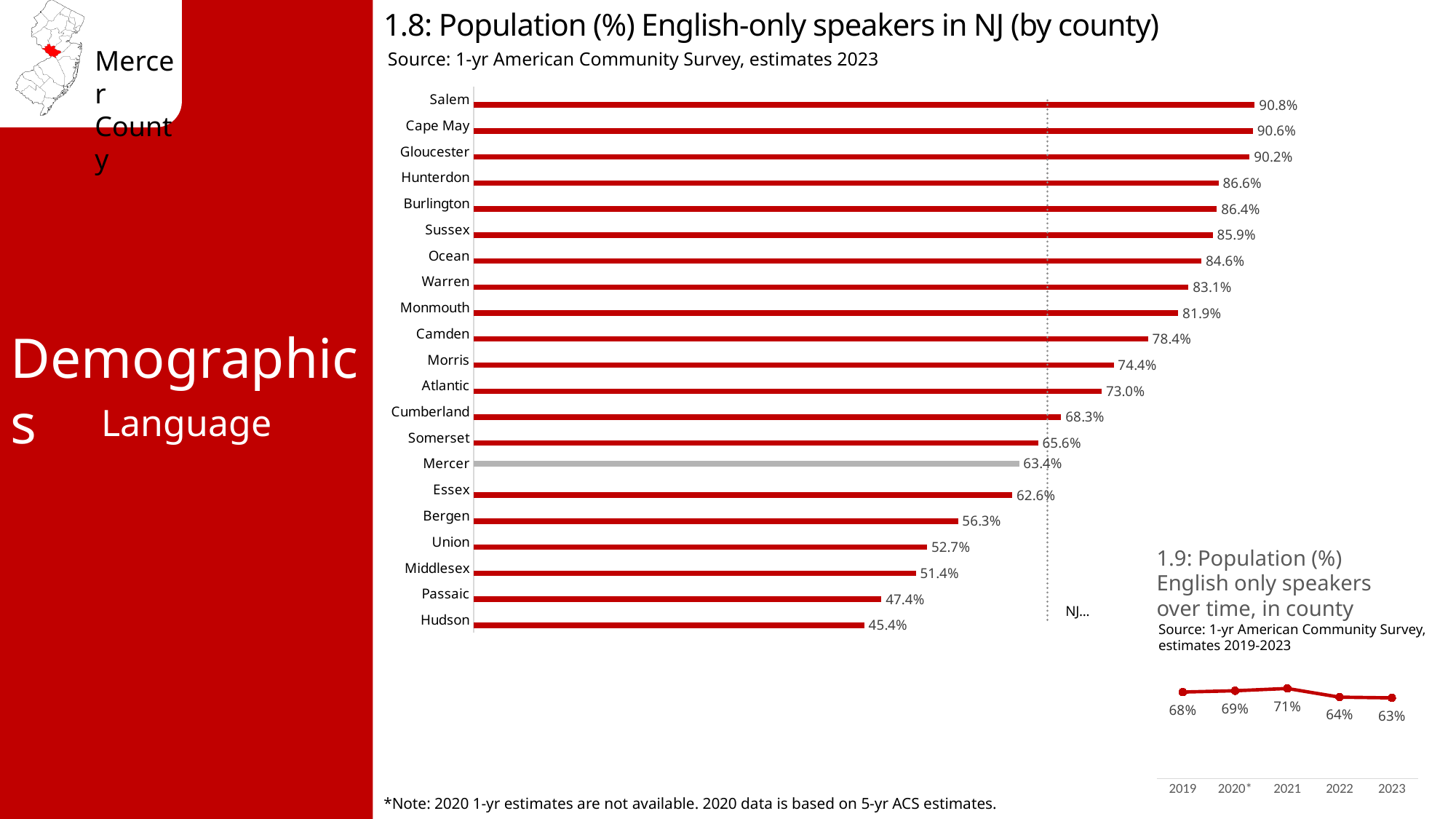
What kind of chart is chart 1.8? Bar chart In chart 1.8, which county has the lowest percentage of English-only speakers? Hudson In chart 1.8, which has a higher value, Camden or Morris? Camden In chart 1.8, what is the difference between the values for Salem and Hudson? 45.4% In chart 1.8, what is the value for Mercer? 63.4% In chart 1.8, what is the value for Hudson? 45.4% In chart 1.8, how many counties are shown? 21 In chart 1.9, how many years are plotted? 5 In chart 1.9, what is the difference between the values for 2021 and 2023? 8% In chart 1.9, what is the value for 2021? 71% In chart 1.8, which county has the highest percentage of English-only speakers? Salem In chart 1.8, which county's bar is shown in grey instead of red? Mercer